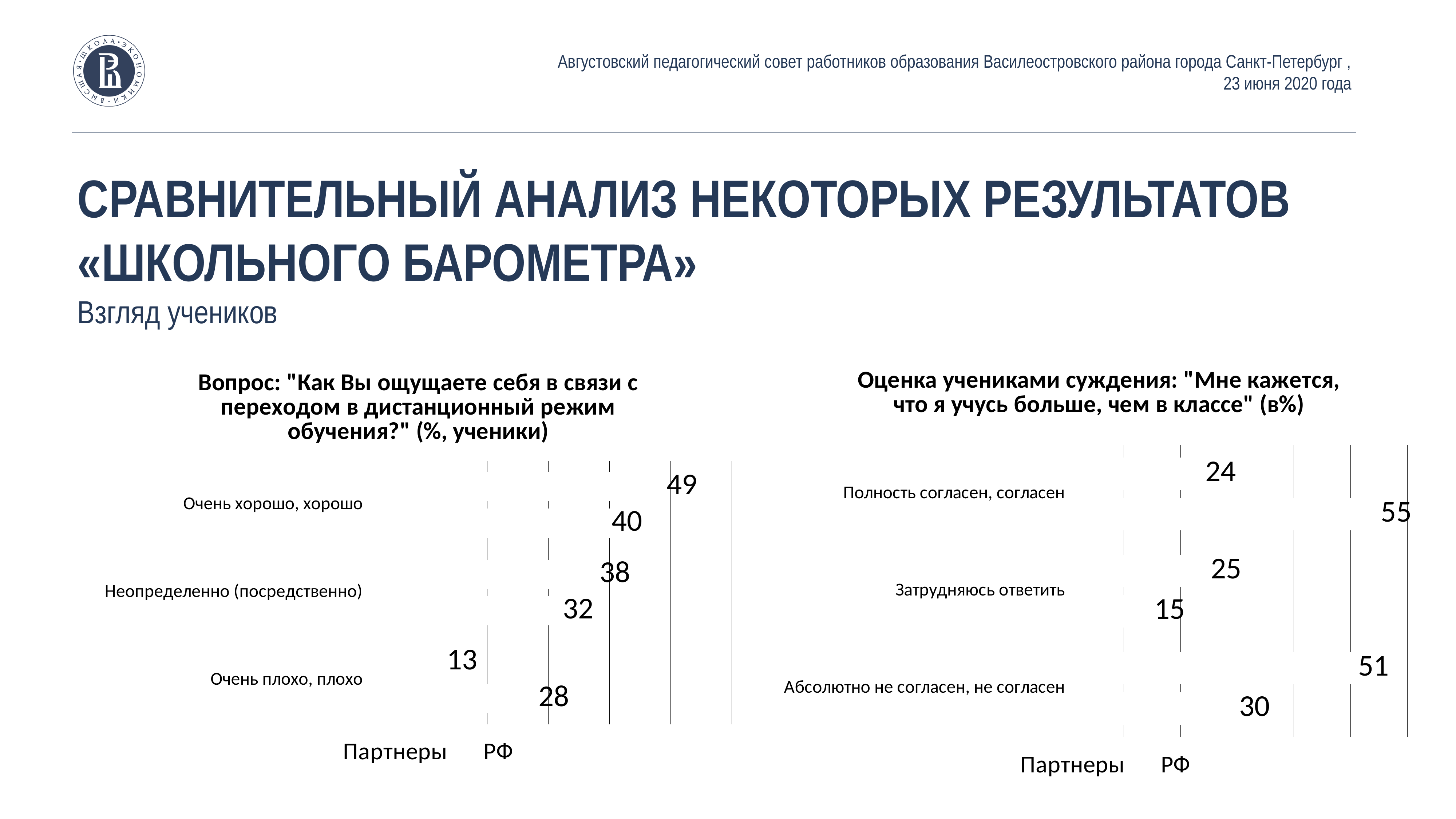
In the right chart, what is the lowest value shown? 15 In the left chart, what are the two values shown for 'Неопределенно (посредственно)'? 38 and 32 In the left chart, what is the highest value shown? 49 How many categories does the left chart show? 3 In the right chart, what is the highest value shown? 55 What are the two legend entries of the right chart? Партнеры and РФ In the left chart, what is the difference between the two values shown for 'Очень плохо, плохо'? 15 How many series does the legend of the left chart list? 2 In the left chart, what is the lowest value shown? 13 In the right chart, what is the difference between the two values shown for 'Полность согласен, согласен'? 31 In the left chart, what are the two values shown for 'Очень плохо, плохо'? 13 and 28 In the right chart, what are the two values shown for 'Полность согласен, согласен'? 24 and 55